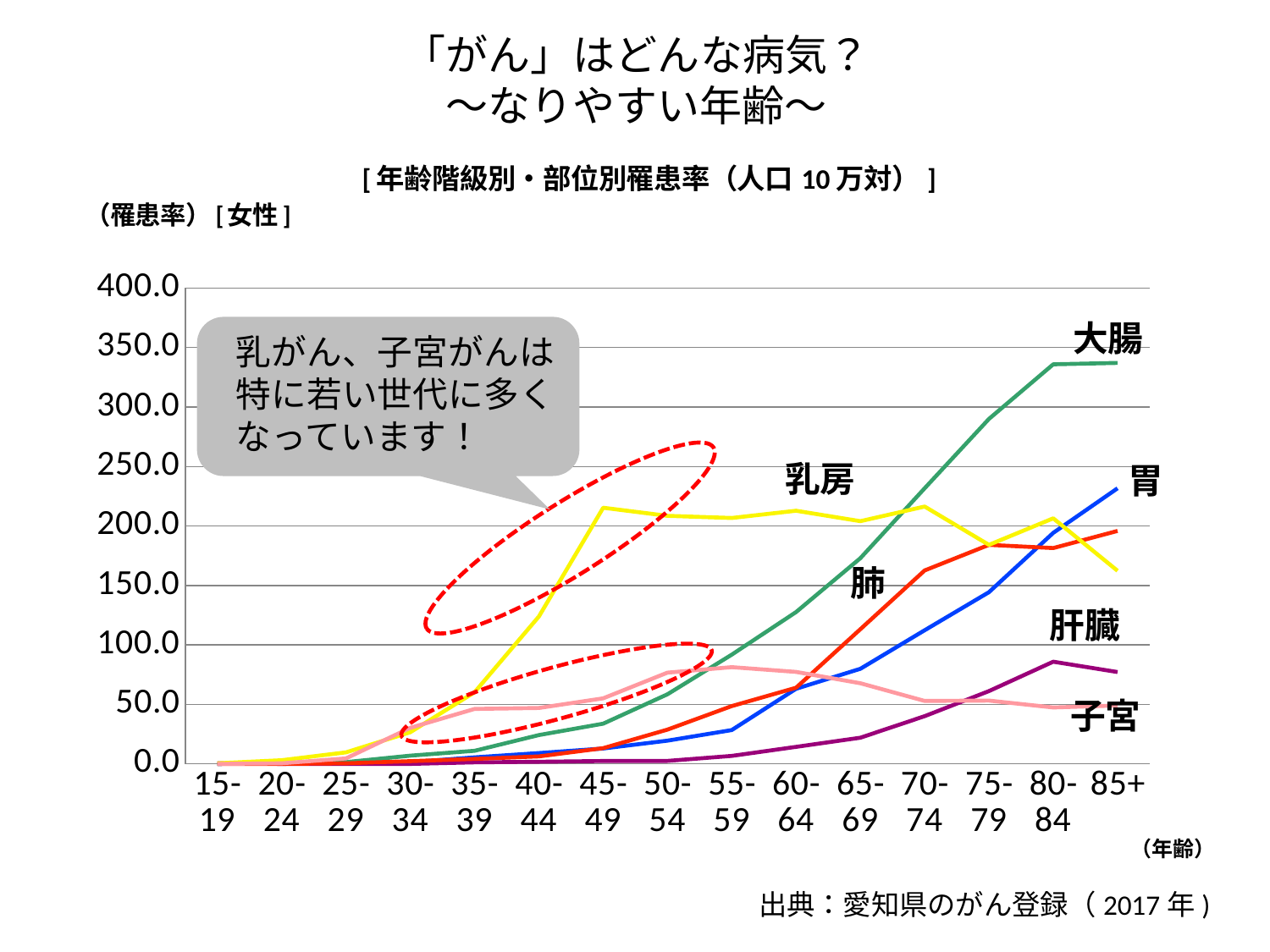
Which cancer site has the lowest incidence rate in the 85+ age group? 子宮 What kind of chart is shown on the slide? line chart Is the value for 肝臓 in the 80-84 age group greater or less than 100? less Is the value for 大腸 in the 85+ age group greater or less than 300? greater How many age groups are shown along the x axis? 15 In the 45-49 age group, which is larger, 乳房 or 大腸? 乳房 Which cancer site has the highest incidence rate in the 85+ age group? 大腸 Is the value for 胃 in the 85+ age group greater or less than 200? greater What is the source cited for the chart data? 愛知県のがん登録（2017年） How many cancer sites (series) are plotted on the chart? 6 Does the 大腸 line generally rise or fall as age increases along the x axis? rise In the 70-74 age group, which is larger, 肺 or 胃? 肺